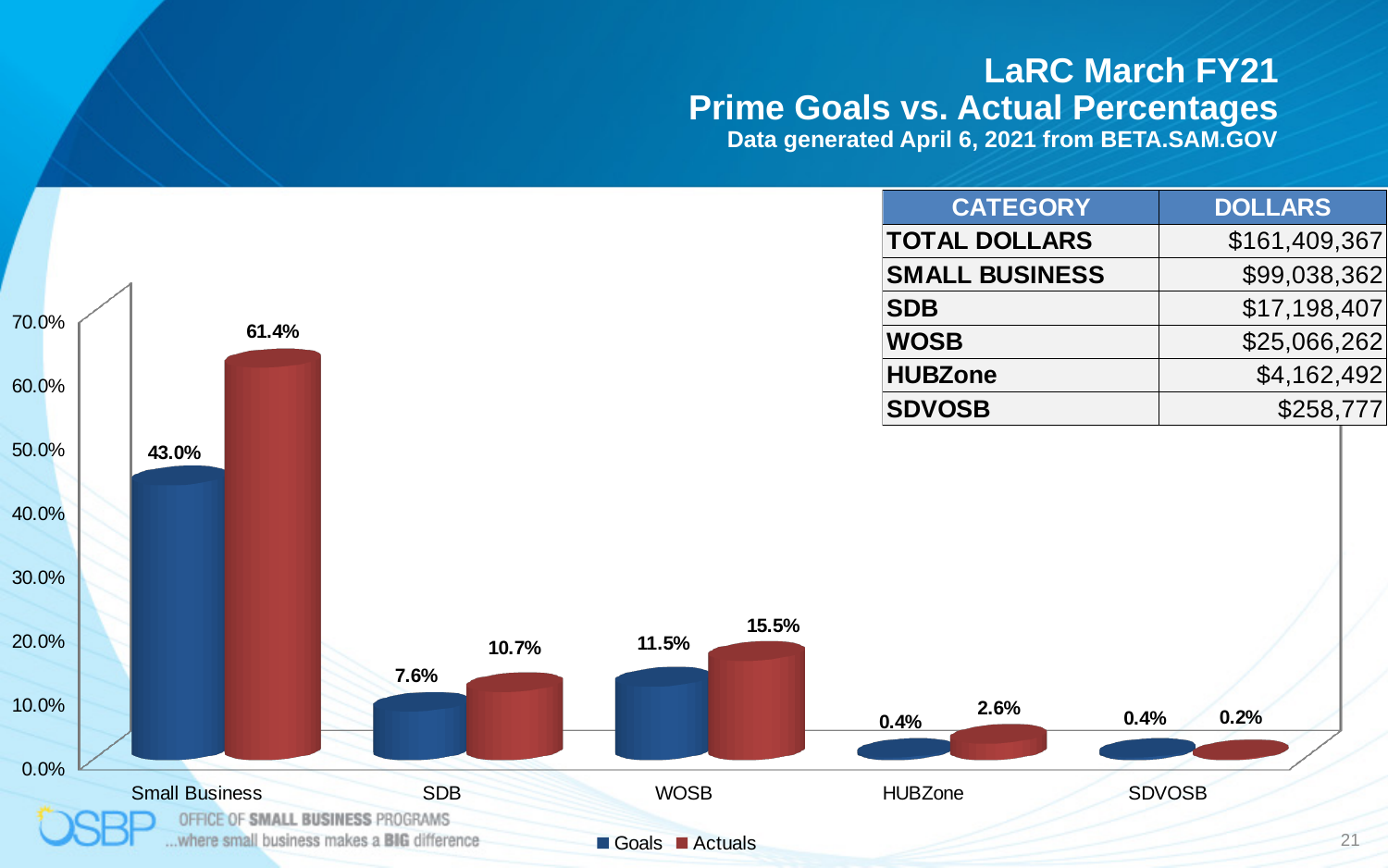
What is the Actuals value for Small Business? 61.4% Is the Actuals value for Small Business greater or less than 60.0%? greater What kind of chart is shown on the slide? Bar chart Which is larger for SDVOSB, the Goals value or the Actuals value? Goals How many categories are shown on the x axis? 5 How many series does the legend list? 2 Which category has the highest Actuals value? Small Business What is the difference between the Actuals and Goals values for SDB? 3.1% Which category has the lowest Actuals value? SDVOSB What is the difference between the Actuals and Goals values for Small Business? 18.4% What is the Actuals value for HUBZone? 2.6% What is the Goals value for WOSB? 11.5%